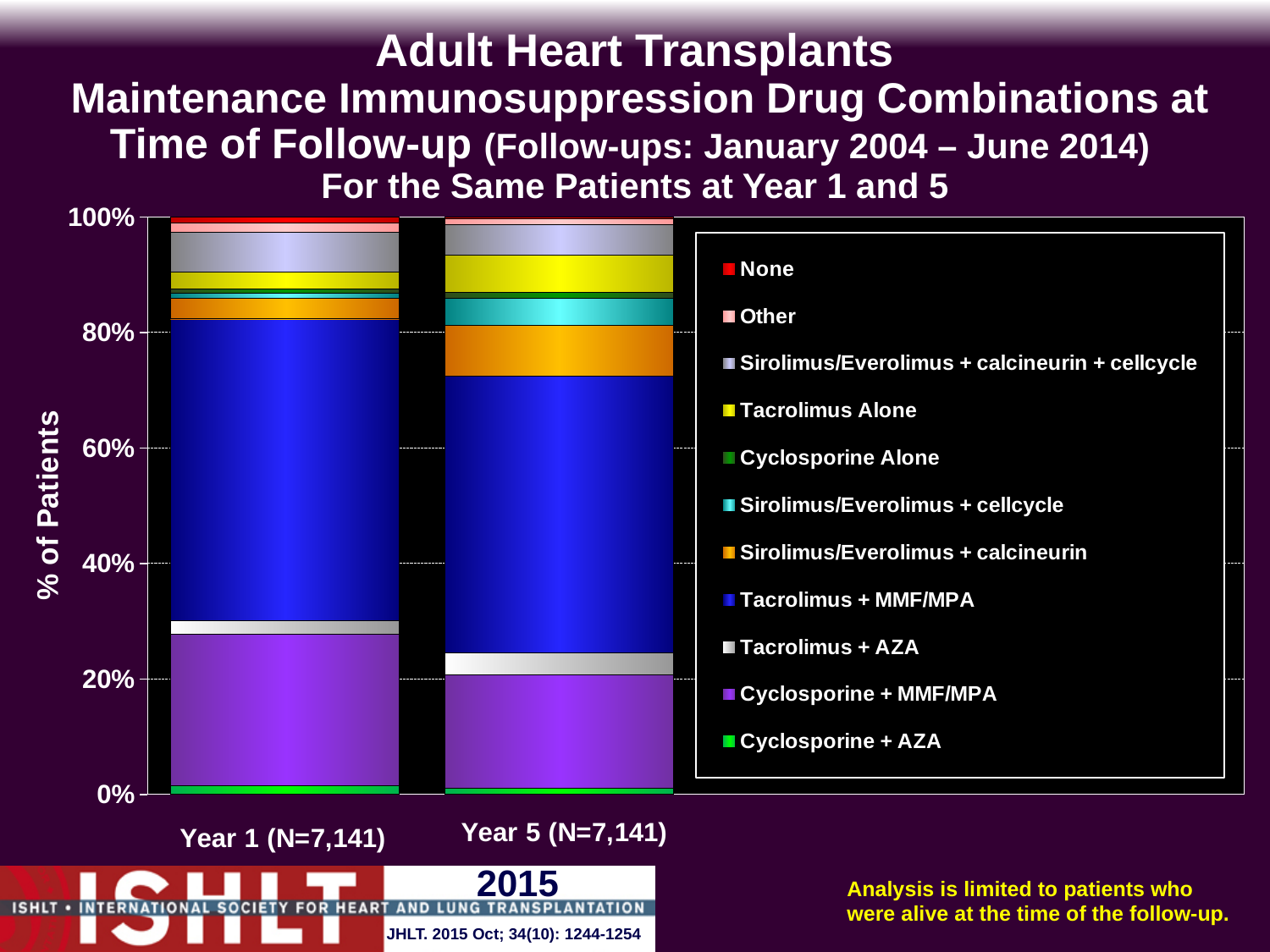
What is the label of the y axis? % of Patients Which legend entry is shown in red? None Does the Cyclosporine + MMF/MPA share rise or fall from Year 1 to Year 5? fall Is the Sirolimus/Everolimus + calcineurin share in the Year 5 bar greater or less than 20%? less What is the N shown for the Year 1 bar? 7,141 Which bar has the larger Sirolimus/Everolimus + calcineurin share, Year 1 or Year 5? Year 5 Which bar has the larger Cyclosporine + MMF/MPA share, Year 1 or Year 5? Year 1 What kind of chart is shown on the slide? Stacked bar chart Is the Tacrolimus + MMF/MPA share in the Year 1 bar greater or less than 40%? greater Is the Cyclosporine + MMF/MPA share in the Year 1 bar greater or less than 20%? greater How many series does the legend list? 11 How many bars (categories) are plotted on the x axis? 2